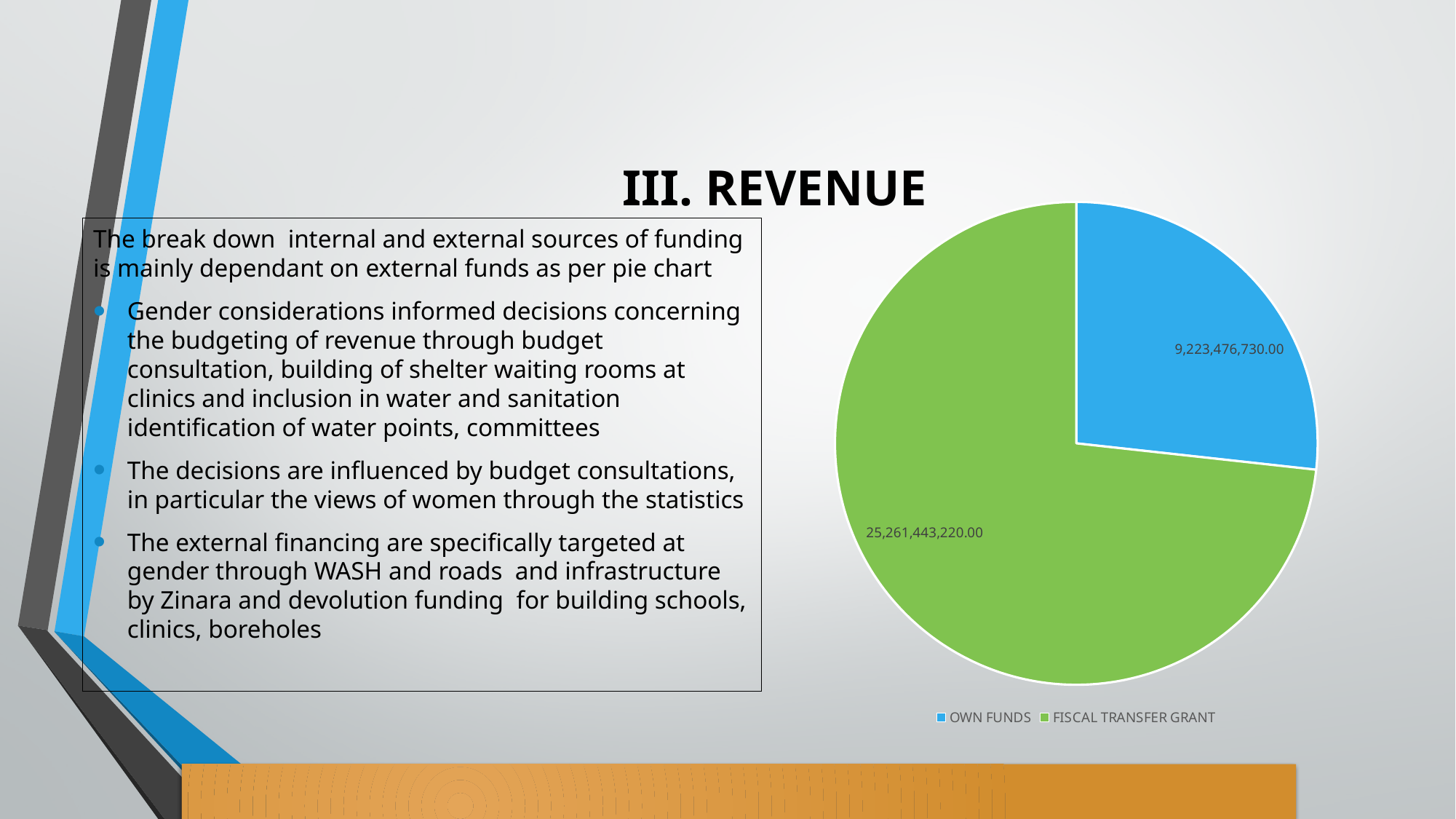
What is the value for FISCAL TRANSFER GRANT in the pie chart? 25,261,443,220.00 What type of chart is shown on the slide? Pie chart How many entries does the legend list? 2 What is the value for OWN FUNDS in the pie chart? 9,223,476,730.00 What is the difference between FISCAL TRANSFER GRANT and OWN FUNDS? 16,037,966,490.00 What colour is the OWN FUNDS slice in the pie chart? Blue Which is larger, OWN FUNDS or FISCAL TRANSFER GRANT? FISCAL TRANSFER GRANT Which category has the smallest slice in the pie chart? OWN FUNDS Which category has the largest slice in the pie chart? FISCAL TRANSFER GRANT How many categories does the pie chart show? 2 What is the total of the two slices in the pie chart? 34,484,919,950.00